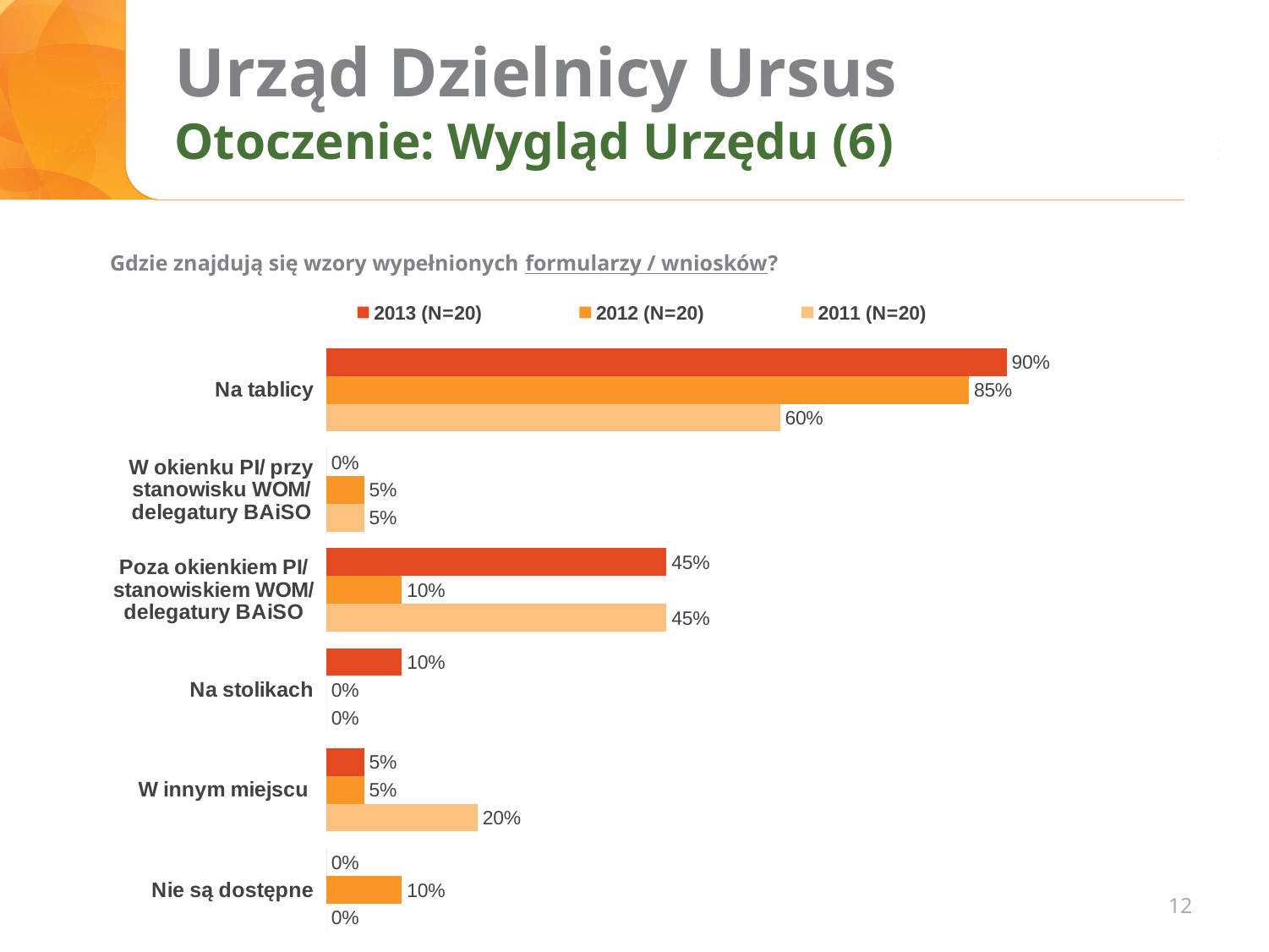
Which is larger for "Poza okienkiem PI/ stanowiskiem WOM/ delegatury BAiSO": the 2013 (N=20) value or the 2012 (N=20) value? 2013 (N=20) What kind of chart is shown on the slide? Bar chart What is the difference between the 2013 (N=20) and 2011 (N=20) values for "Na tablicy"? 30% How many series does the legend list? 3 How many categories are shown on the chart? 6 What is the value for "Poza okienkiem PI/ stanowiskiem WOM/ delegatury BAiSO" in the 2012 (N=20) series? 10% What is the value for "Na tablicy" in the 2011 (N=20) series? 60% Which category has the highest value in the 2013 (N=20) series? Na tablicy What is the value for "Nie są dostępne" in the 2012 (N=20) series? 10% What is the value for "W innym miejscu" in the 2011 (N=20) series? 20% What question does the chart answer, according to the text above it? Gdzie znajdują się wzory wypełnionych formularzy / wniosków? What is the value for "Na tablicy" in the 2013 (N=20) series? 90%